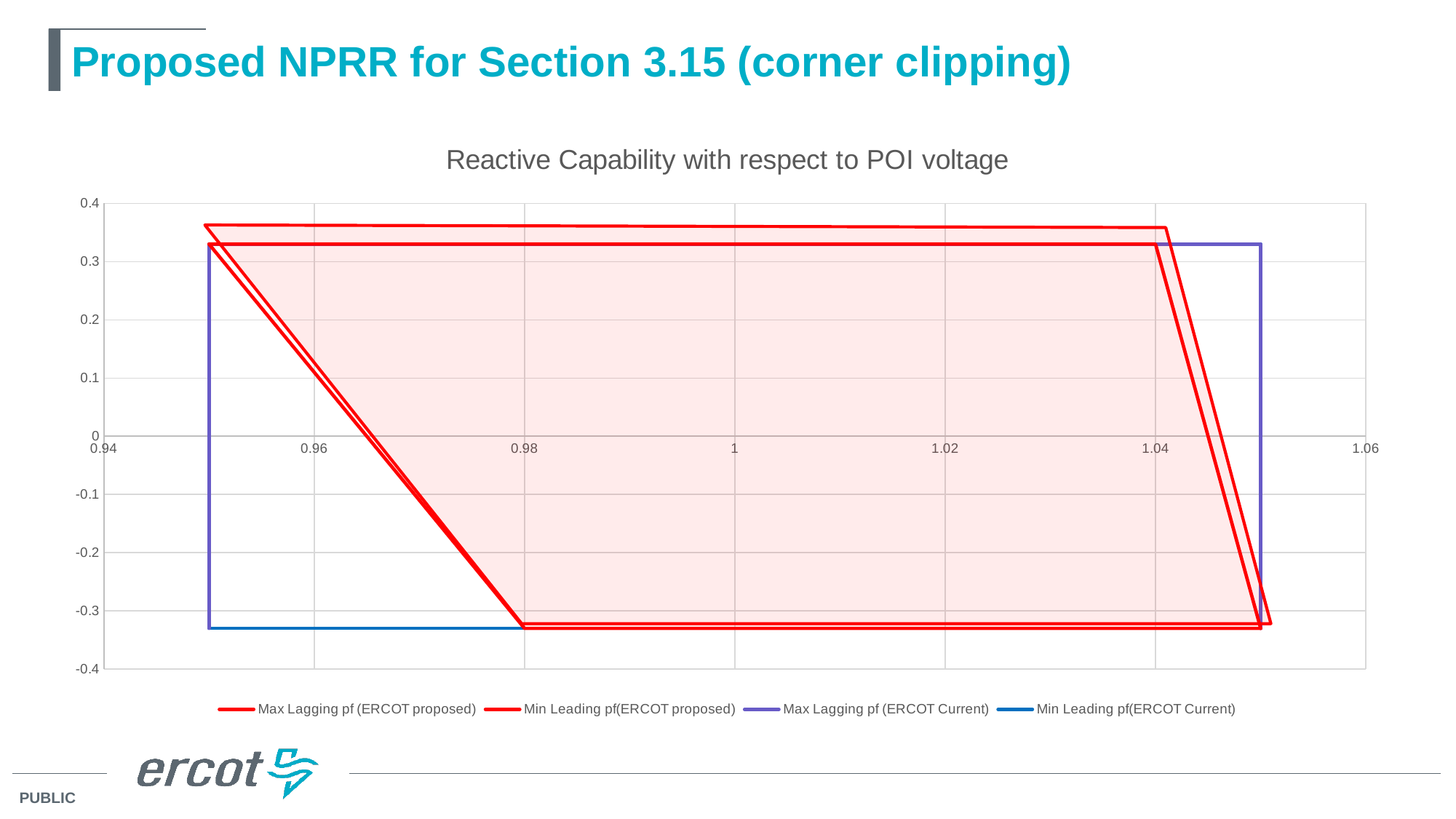
How many series does the legend list? 4 Is the value for Min Leading pf(ERCOT proposed) at a POI voltage of 0.96 greater or less than -0.2? greater At a POI voltage of 0.96, which is higher: Min Leading pf(ERCOT proposed) or Min Leading pf(ERCOT Current)? Min Leading pf(ERCOT proposed) Does the Max Lagging pf (ERCOT proposed) line rise or fall as POI voltage increases from 1.04 to 1.05? fall What is the title of the chart? Reactive Capability with respect to POI voltage What kind of chart is shown on the slide? line chart Is the value for Max Lagging pf (ERCOT proposed) at a POI voltage of 1 greater or less than 0.3? greater Is the value for Max Lagging pf (ERCOT Current) at a POI voltage of 1 greater or less than 0.3? greater Does the Min Leading pf(ERCOT proposed) line rise or fall as POI voltage increases from 0.95 to 0.98? fall What colour are the ERCOT proposed series drawn in? red